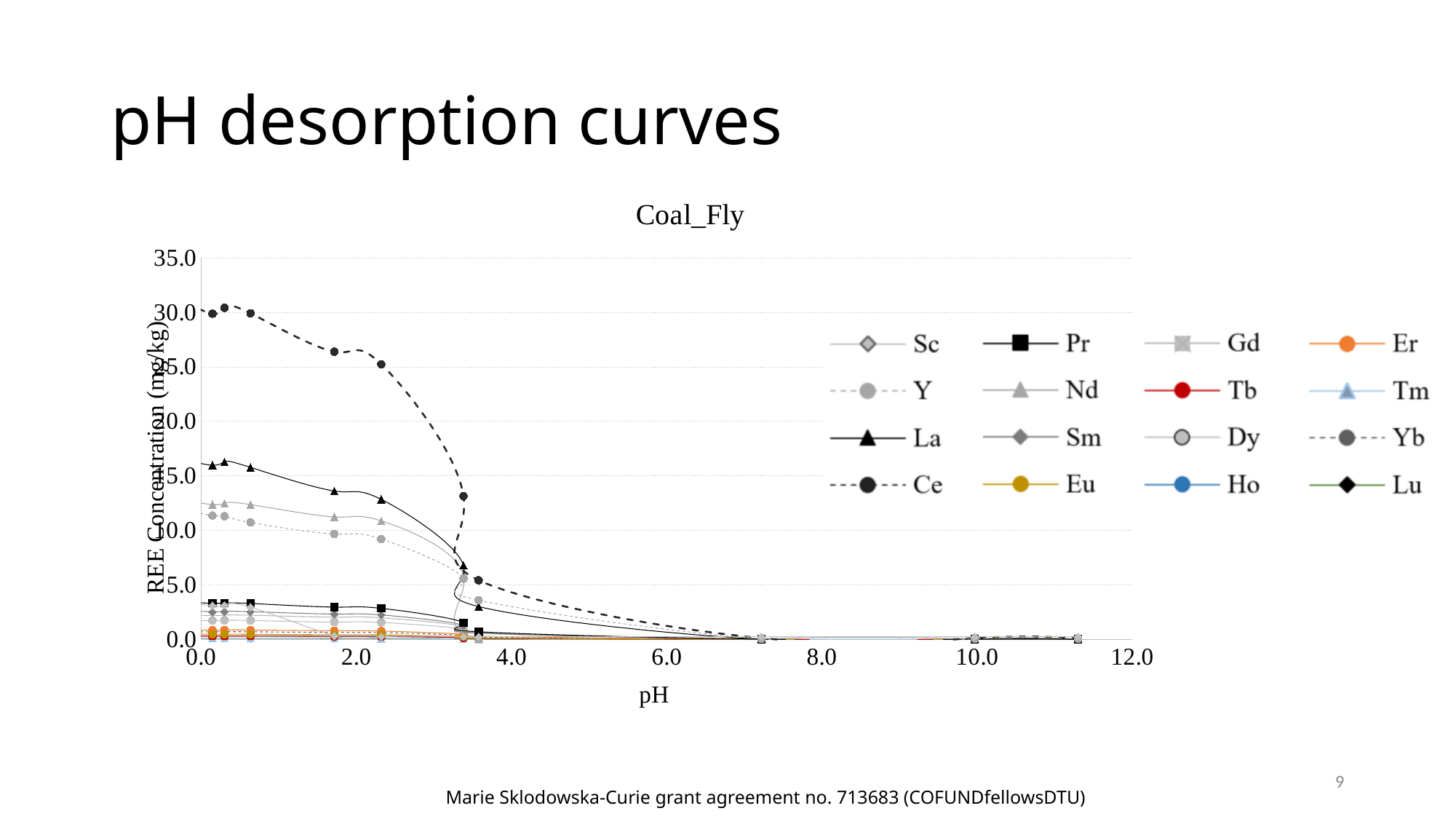
At pH around 2, which series has the larger concentration, La or Pr? La What kind of chart is shown on the slide? line chart Is the La concentration at pH near 0 greater or less than 10.0 mg/kg? greater Is the Ce concentration at pH near 0 greater or less than 25.0 mg/kg? greater Does the Ce concentration rise or fall as pH increases? fall What is the title of the chart? Coal_Fly At pH around 2, which series has the larger concentration, Ce or La? Ce Which series has the highest REE concentration at low pH (around pH 0 to 2)? Ce What is the label of the y axis? REE Concentration (mg/kg) Is the Ce concentration at pH around 8 greater or less than 5.0 mg/kg? less How many series does the legend of the Coal_Fly chart list? 16